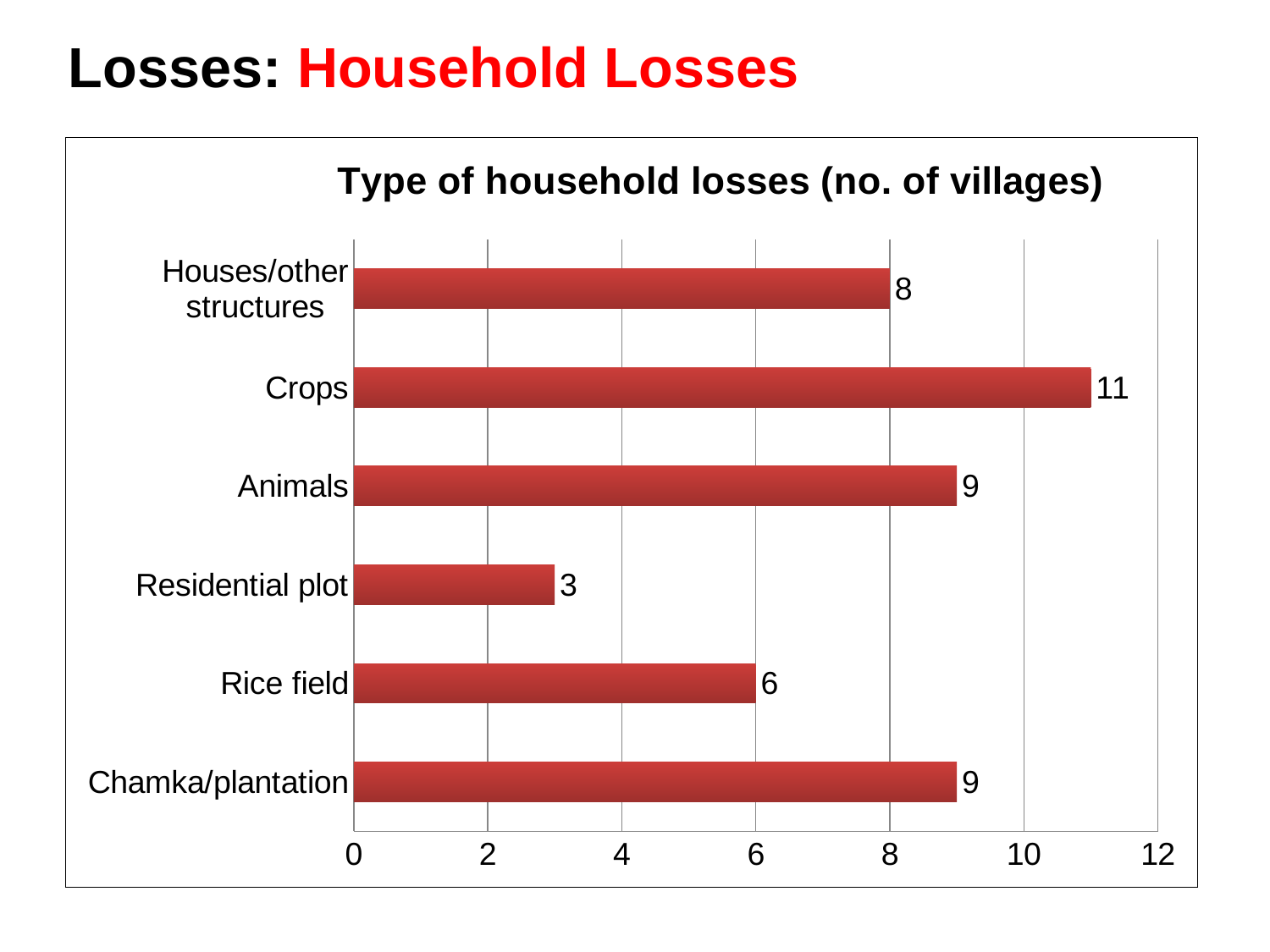
What is the value for Crops? 11 What is the value for Rice field? 6 What kind of chart is shown on the slide? bar chart Is the value for Chamka/plantation greater or less than 8? greater What is the value for Residential plot? 3 What is the difference between the values for Crops and Rice field? 5 Which category has the highest value? Crops Which is larger, the value for Animals or the value for Houses/other structures? Animals What is the value for Houses/other structures? 8 Which category has the lowest value? Residential plot How many categories are shown in the chart? 6 What is the title of the chart? Type of household losses (no. of villages)